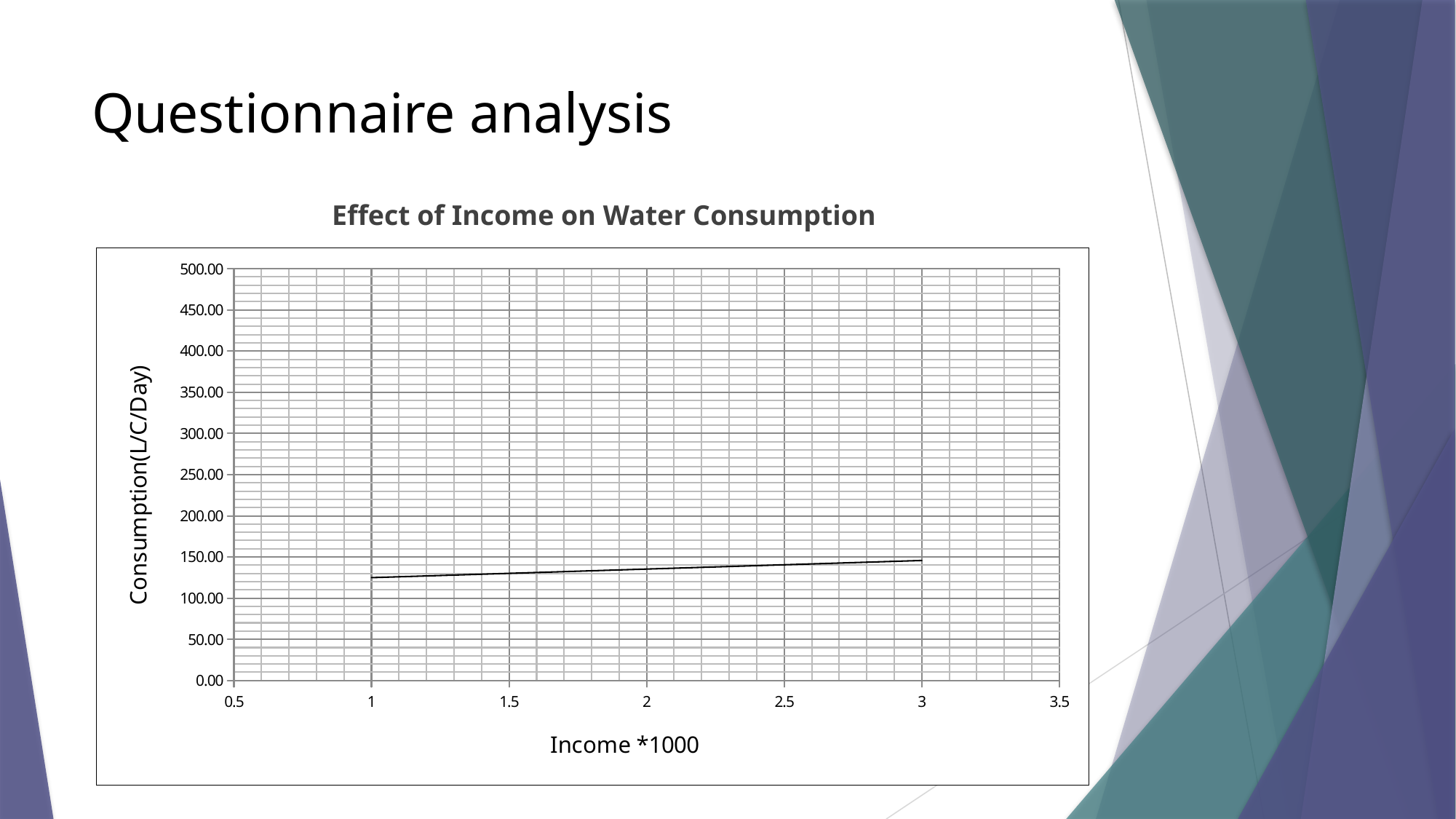
What is the label of the y axis? Consumption(L/C/Day) Is the consumption value at income 1 (*1000) greater or less than 150? less Which has the higher consumption value: income 1 (*1000) or income 3 (*1000)? income 3 (*1000) What type of chart is shown on the slide? line chart Is the consumption value at income 3 (*1000) greater or less than 100? greater Is the consumption value at income 1 (*1000) greater or less than 100? greater Does water consumption rise or fall as income increases along the x axis? rise What is the title of the chart? Effect of Income on Water Consumption